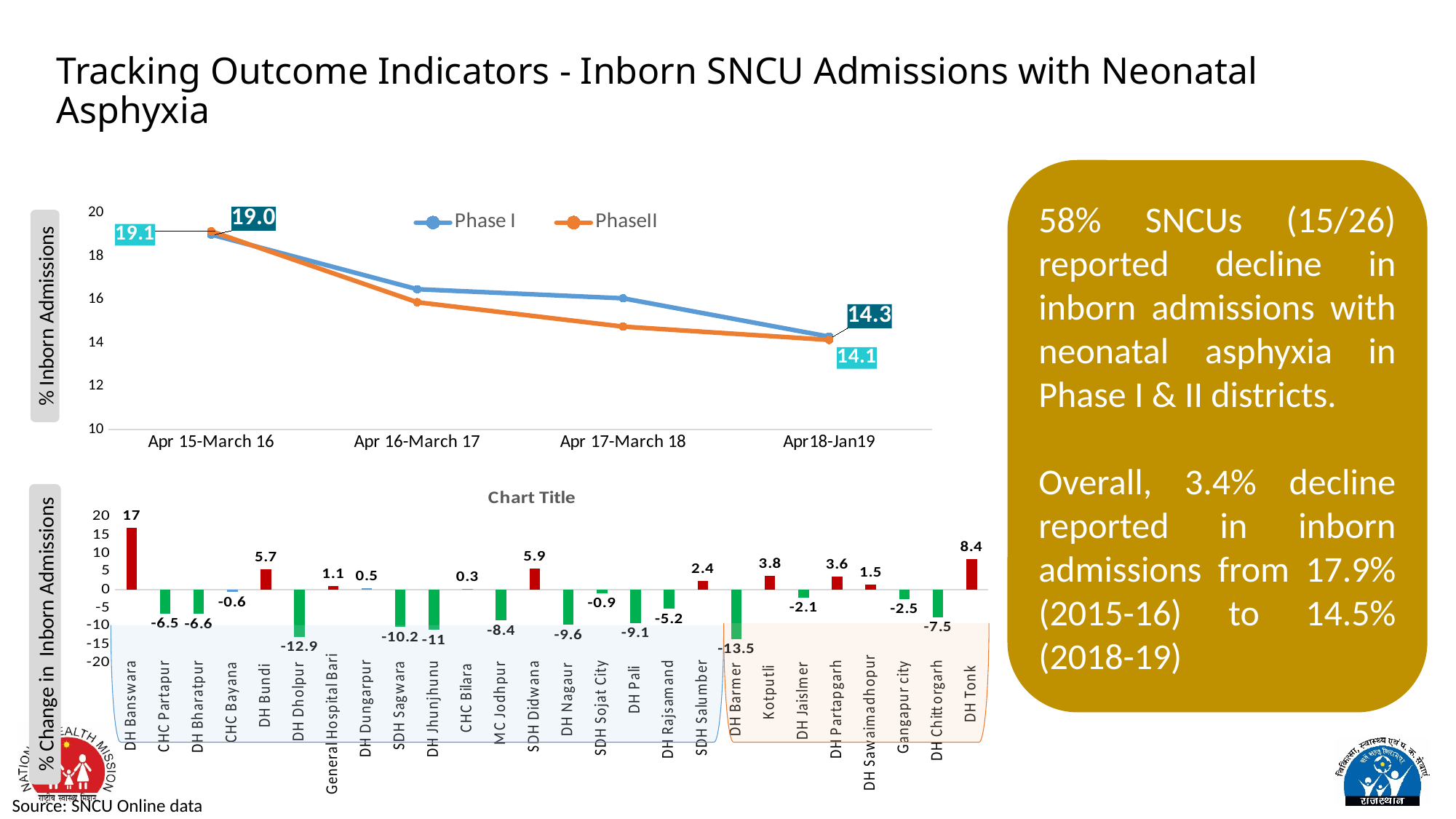
On the bottom chart titled 'Chart Title', what is the difference between the values for DH Tonk and DH Bundi? 2.7 What kind of chart is the bottom chart titled 'Chart Title'? bar chart On the top line chart, how many series does the legend list? 2 On the bottom chart titled 'Chart Title', which facility has the highest value? DH Banswara On the top line chart, do the Phase I values rise or fall from Apr 15-March 16 to Apr18-Jan19? fall On the bottom chart titled 'Chart Title', what is the value for DH Dholpur? -12.9 On the top line chart, is the PhaseII value for Apr 17-March 18 greater or less than 16? less On the top line chart, is the Phase I value for Apr 16-March 17 greater or less than 16? greater On the bottom chart titled 'Chart Title', which facility has the lowest value? DH Barmer On the bottom chart titled 'Chart Title', how many facilities are shown on the x axis? 26 On the top line chart, what is the Phase I value for Apr18-Jan19? 14.3 On the top line chart, what is the PhaseII value for Apr18-Jan19? 14.1